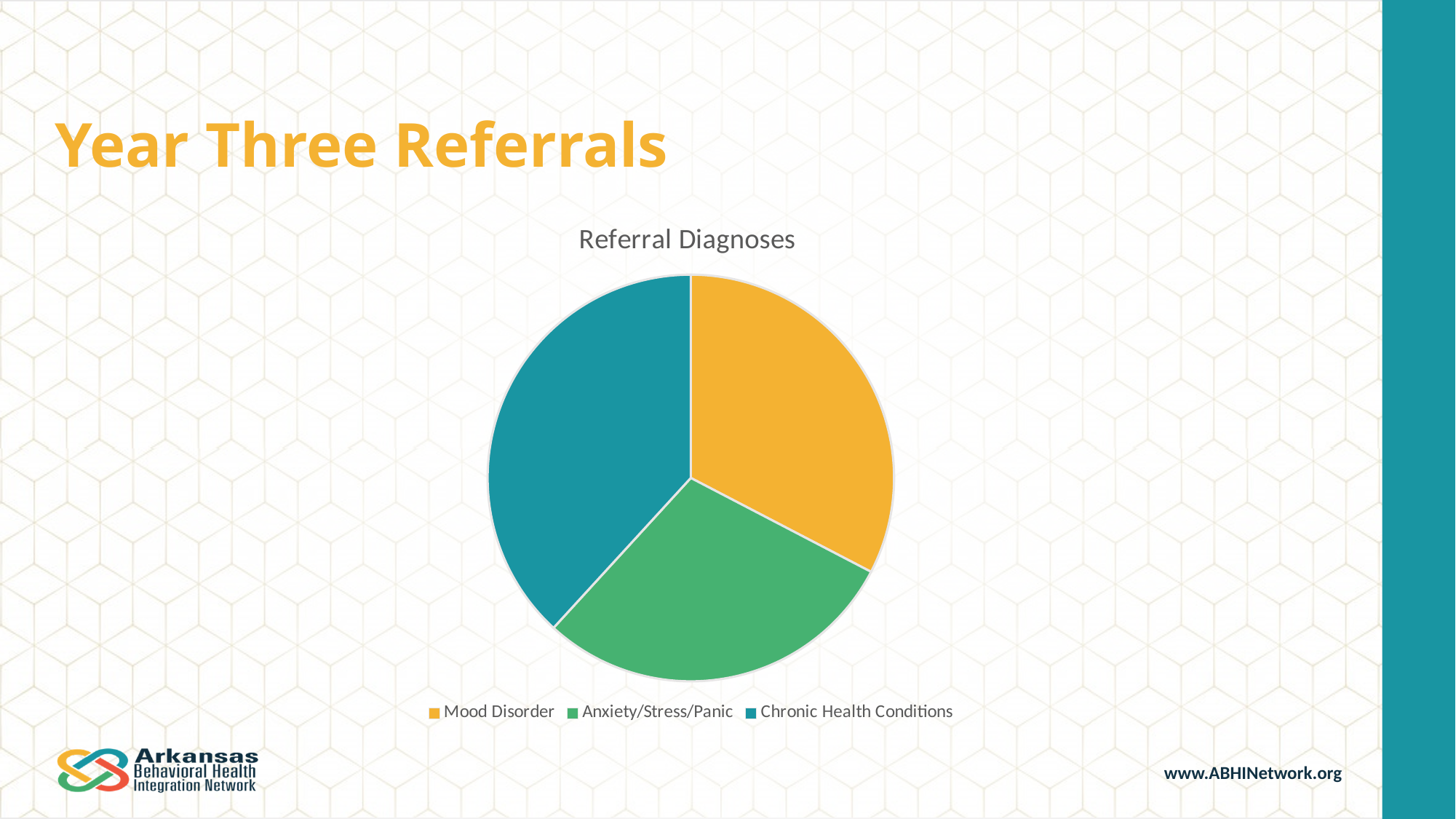
Which category has the largest slice of the pie? Chronic Health Conditions Which legend entry is listed between Mood Disorder and Chronic Health Conditions? Anxiety/Stress/Panic Which slice is larger, Chronic Health Conditions or Anxiety/Stress/Panic? Chronic Health Conditions How many slices does the pie chart have? 3 How many entries does the legend list? 3 What is the title of the chart? Referral Diagnoses What kind of chart is shown on the slide? pie chart Which category is shown in yellow in the pie chart? Mood Disorder